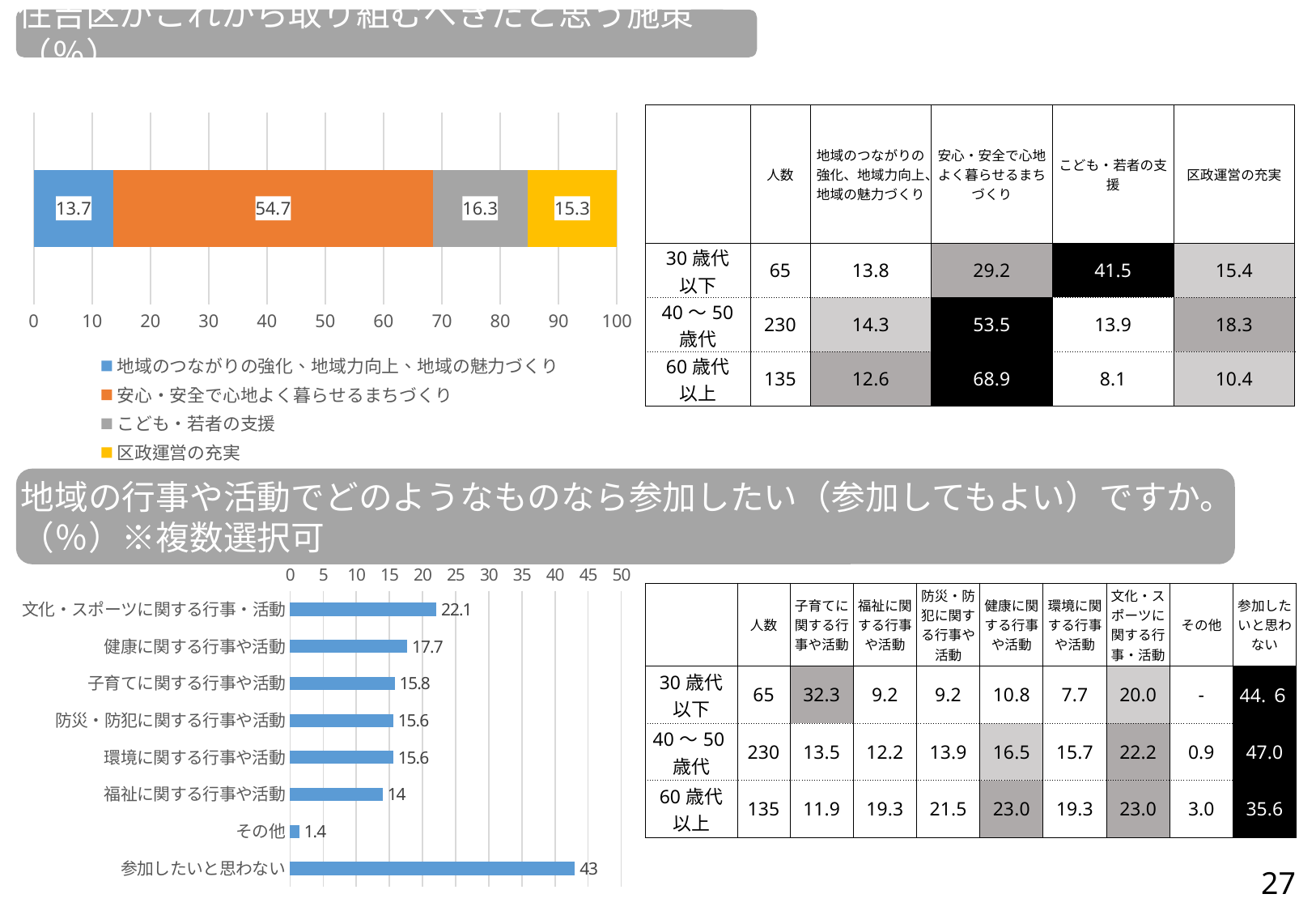
In the bottom chart titled 地域の行事や活動でどのようなものなら参加したい（参加してもよい）ですか。, what is the value for 文化・スポーツに関する行事・活動? 22.1 In the bottom chart titled 地域の行事や活動でどのようなものなら参加したい（参加してもよい）ですか。, which category has the highest value? 参加したいと思わない In the stacked bar chart at the top of the slide, what is the difference between こども・若者の支援 and 区政運営の充実? 1.0 In the stacked bar chart at the top of the slide, how many series does the legend list? 4 In the stacked bar chart at the top of the slide, which segment is the largest? 安心・安全で心地よく暮らせるまちづくり In the stacked bar chart at the top of the slide, what is the value for 安心・安全で心地よく暮らせるまちづくり? 54.7 In the bottom chart titled 地域の行事や活動でどのようなものなら参加したい（参加してもよい）ですか。, how many categories are shown? 8 In the stacked bar chart at the top of the slide, what is the value for 区政運営の充実? 15.3 In the bottom chart titled 地域の行事や活動でどのようなものなら参加したい（参加してもよい）ですか。, what is the difference between 健康に関する行事や活動 and 福祉に関する行事や活動? 3.7 In the stacked bar chart at the top of the slide, what colour is the segment for 区政運営の充実? Yellow In the bottom chart titled 地域の行事や活動でどのようなものなら参加したい（参加してもよい）ですか。, which category has the lowest value? その他 In the stacked bar chart at the top of the slide, which segment is the smallest? 地域のつながりの強化、地域力向上、地域の魅力づくり